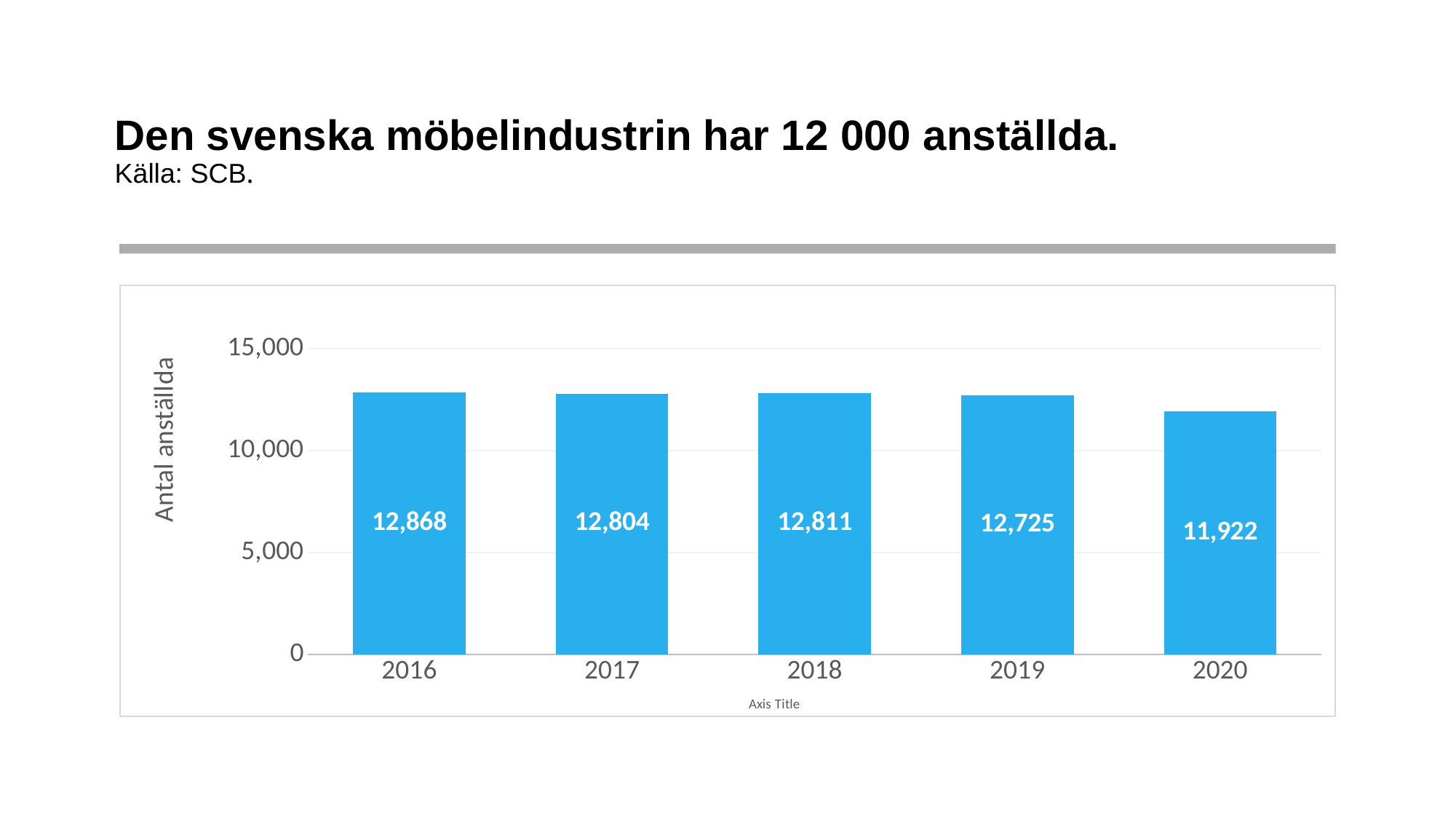
What is the difference between the values for 2019 and 2020? 803 What is the value for 2020? 11,922 Which is larger, the value for 2018 or the value for 2020? 2018 What kind of chart is shown on the slide? bar chart What is the value for 2016? 12,868 Which year has the lowest value? 2020 What is the value for 2019? 12,725 Is the value for 2020 greater or less than 15,000? less What is the label of the vertical axis? Antal anställda How many years are shown on the x axis? 5 Which year has the highest value? 2016 What is the difference between the values for 2016 and 2017? 64